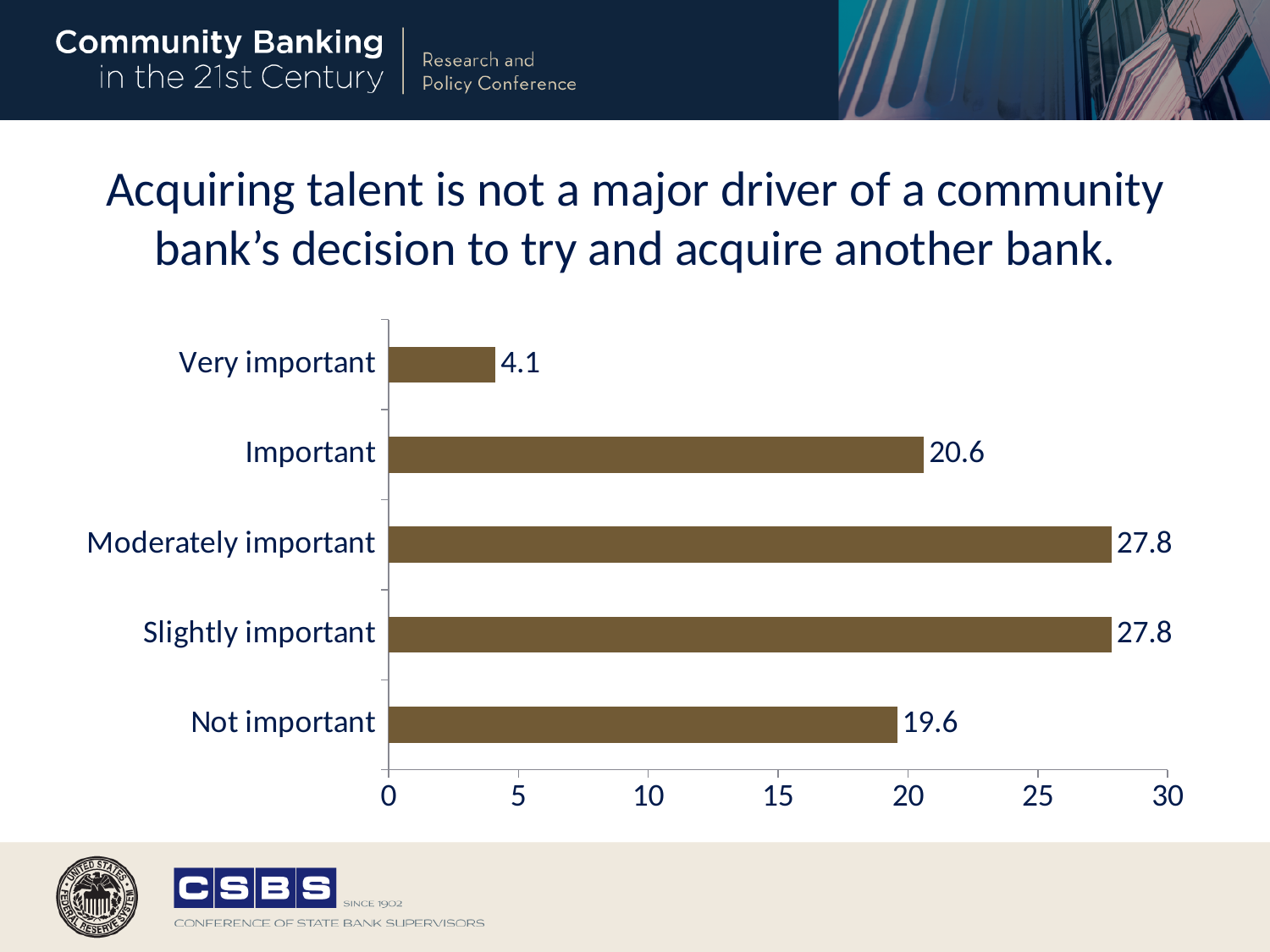
What is the value for Moderately important? 27.8 What is the value for Not important? 19.6 What is the value for Very important? 4.1 What is the difference between the values for Important and Not important? 1.0 Which category has the lowest value? Very important What kind of chart is shown on the slide? bar chart What is the value for Important? 20.6 How many categories are shown in the chart? 5 Which is larger, the value for Important or the value for Very important? Important What is the difference between the values for Moderately important and Very important? 23.7 What is the maximum value shown on the horizontal axis? 30 Is the value for Slightly important greater or less than 25? greater